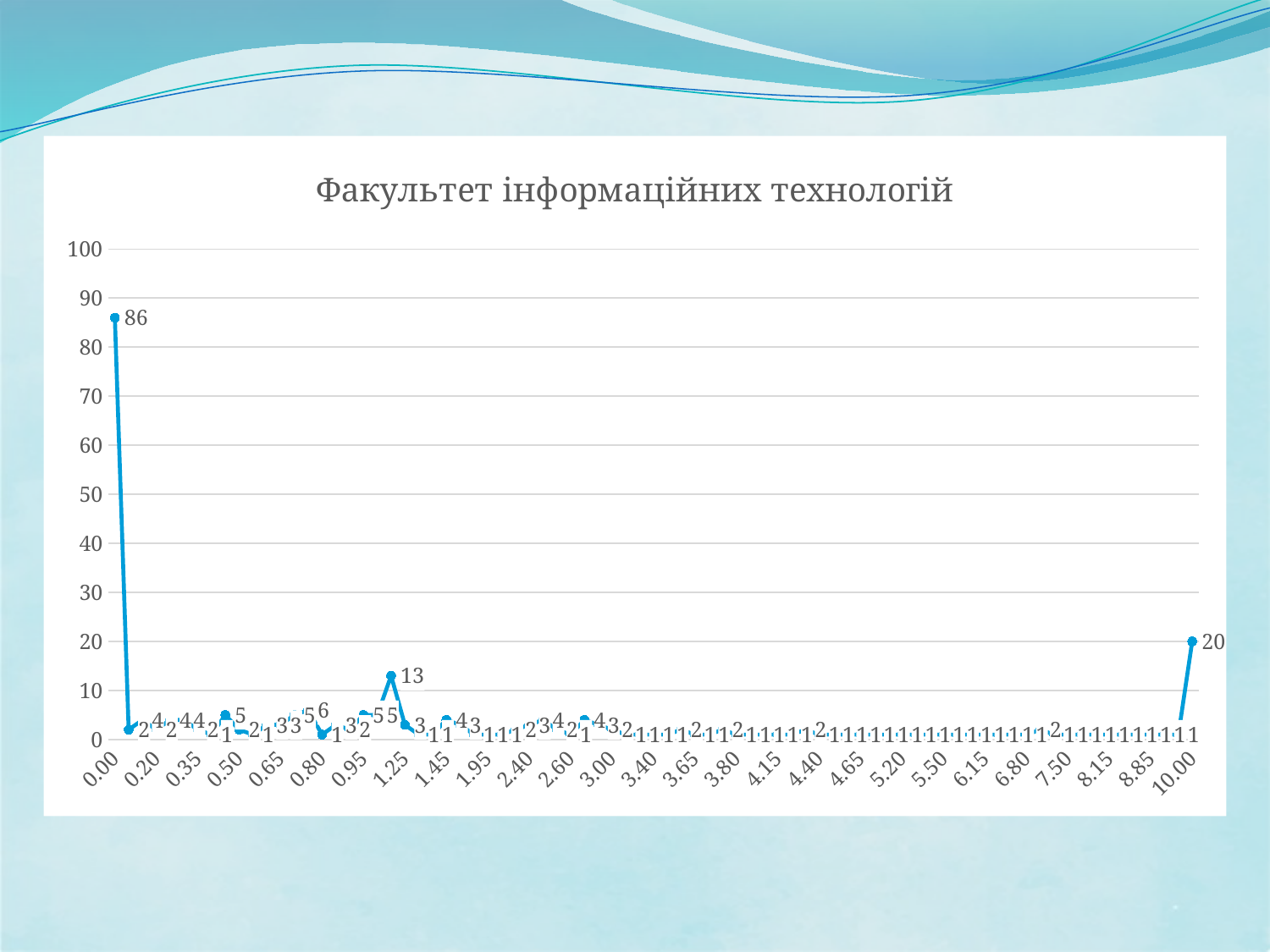
What is the difference between the value at 0.00 and the value at 10.00? 66 What is the title of the chart? Факультет інформаційних технологій Is the value at 0.00 greater or less than 80? greater Which x-axis category has the highest value? 0.00 What is the value at x = 0.00 on the chart? 86 What is the maximum value shown on the y-axis? 100 What is the third-highest data label shown on the chart? 13 Is the value at 10.00 greater or less than 30? less What is the second-highest data label shown on the chart? 20 Which is larger: the value at 0.00 or the value at 10.00? 0.00 What kind of chart is shown on the slide? line chart What is the value at x = 10.00 on the chart? 20